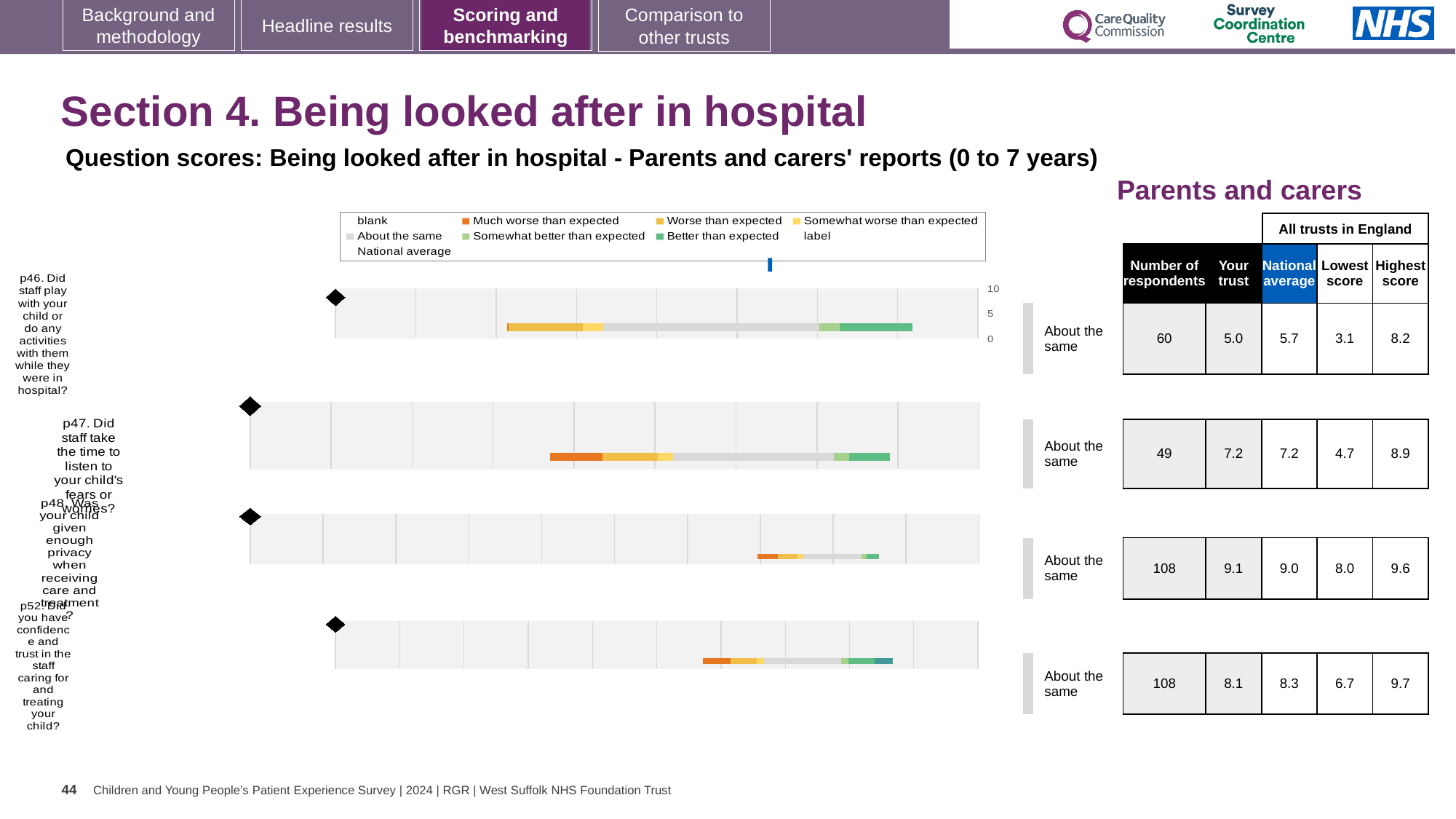
Which question has the highest 'Your trust' score? p48 How many questions (bars) are plotted in the chart? 4 What kind of chart is used to show the question scores on this slide? bar chart How many respondents answered p48 (Was your child given enough privacy when receiving care and treatment?)? 108 What is the highest score across all trusts in England for p52 (Did you have confidence and trust in the staff caring for and treating your child?)? 9.7 What is the difference between the highest score and the lowest score for p46? 5.1 What benchmark category is shown next to each of the four bars? About the same What is the 'Your trust' score for p46 (Did staff play with your child or do any activities with them while they were in hospital?)? 5.0 What is the national average score for p47 (Did staff take the time to listen to your child's fears or worries?)? 7.2 How many entries does the chart legend list? 9 For p52, which is larger: the 'Your trust' score or the national average? National average Which question has the lowest 'Your trust' score? p46